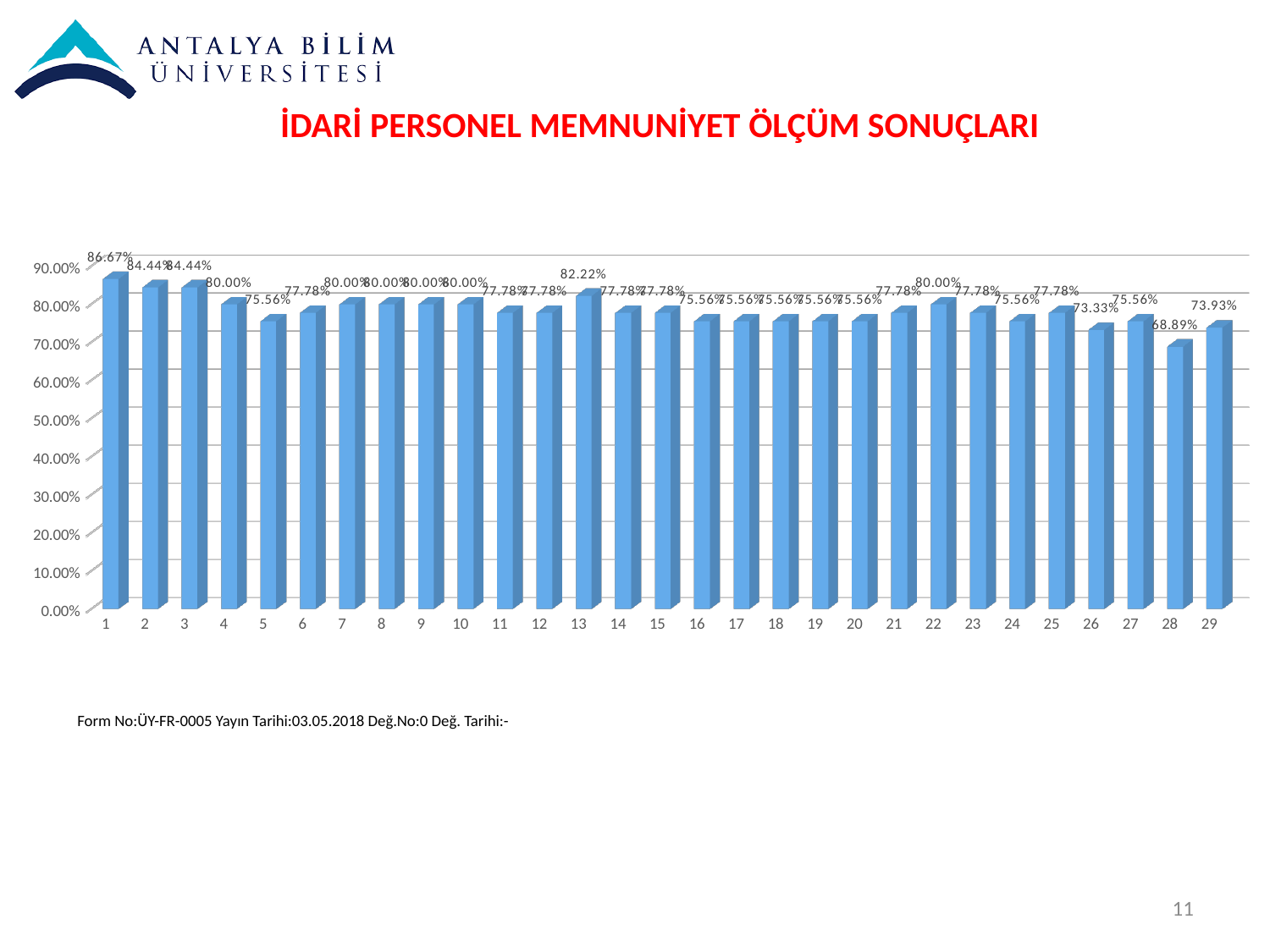
What kind of chart is shown on the slide? bar chart What is the value for category 1? 86.67% Which is larger, the value for category 13 or the value for category 26? 13 How many categories are shown on the x axis? 29 What is the difference between the values for category 1 and category 28? 17.78% What is the value for category 13? 82.22% What is the value for category 29? 73.93% What is the title of the slide? İDARİ PERSONEL MEMNUNİYET ÖLÇÜM SONUÇLARI Is the value for category 5 greater or less than 80.00%? less What is the value for category 28? 68.89% Which category has the highest value? 1 Which category has the lowest value? 28